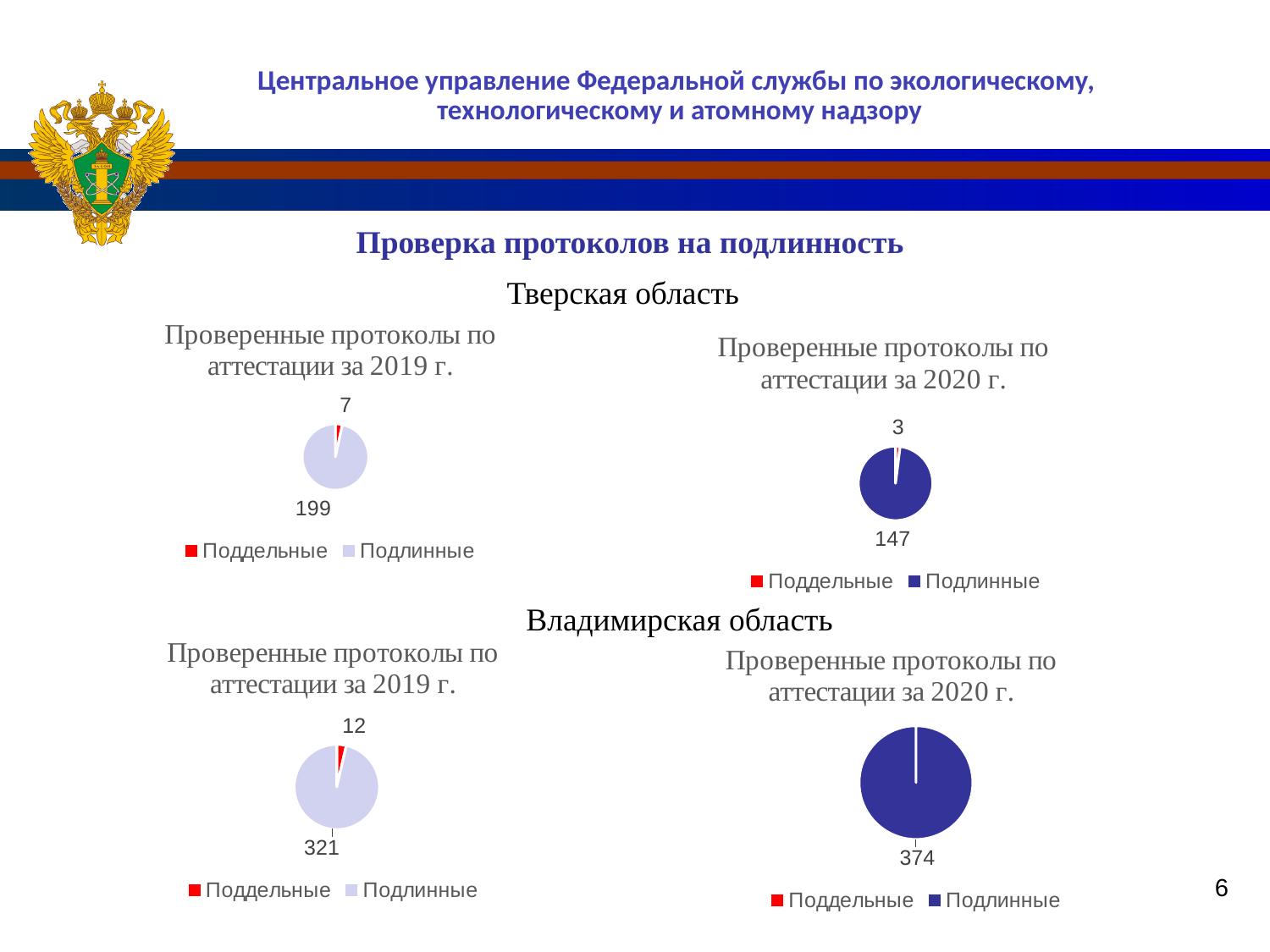
In the Vladimir region 2019 pie chart, what is the value for Подлинные? 321 In the Tver region 2019 pie chart (Проверенные протоколы по аттестации за 2019 г.), how many protocols are labelled Подлинные? 199 In the Tver region 2020 pie chart (Проверенные протоколы по аттестации за 2020 г.), what is the value for Поддельные? 3 In the Vladimir region 2020 pie chart, what value is printed for Подлинные? 374 In the Tver region 2020 pie chart, what is the value for Подлинные? 147 What type of chart is used for the Tver region 2019 data? Pie chart In the Vladimir region 2019 pie chart, what is the value for Поддельные? 12 How many series does the legend of the Vladimir region 2020 chart list? 2 In the Vladimir region 2019 pie chart, what is the total of Поддельные and Подлинные? 333 In the Tver region 2019 pie chart, what is the difference between Подлинные and Поддельные? 192 In the Tver region 2019 pie chart, how many protocols are labelled Поддельные? 7 In the Tver region 2020 pie chart, which category is larger, Поддельные or Подлинные? Подлинные